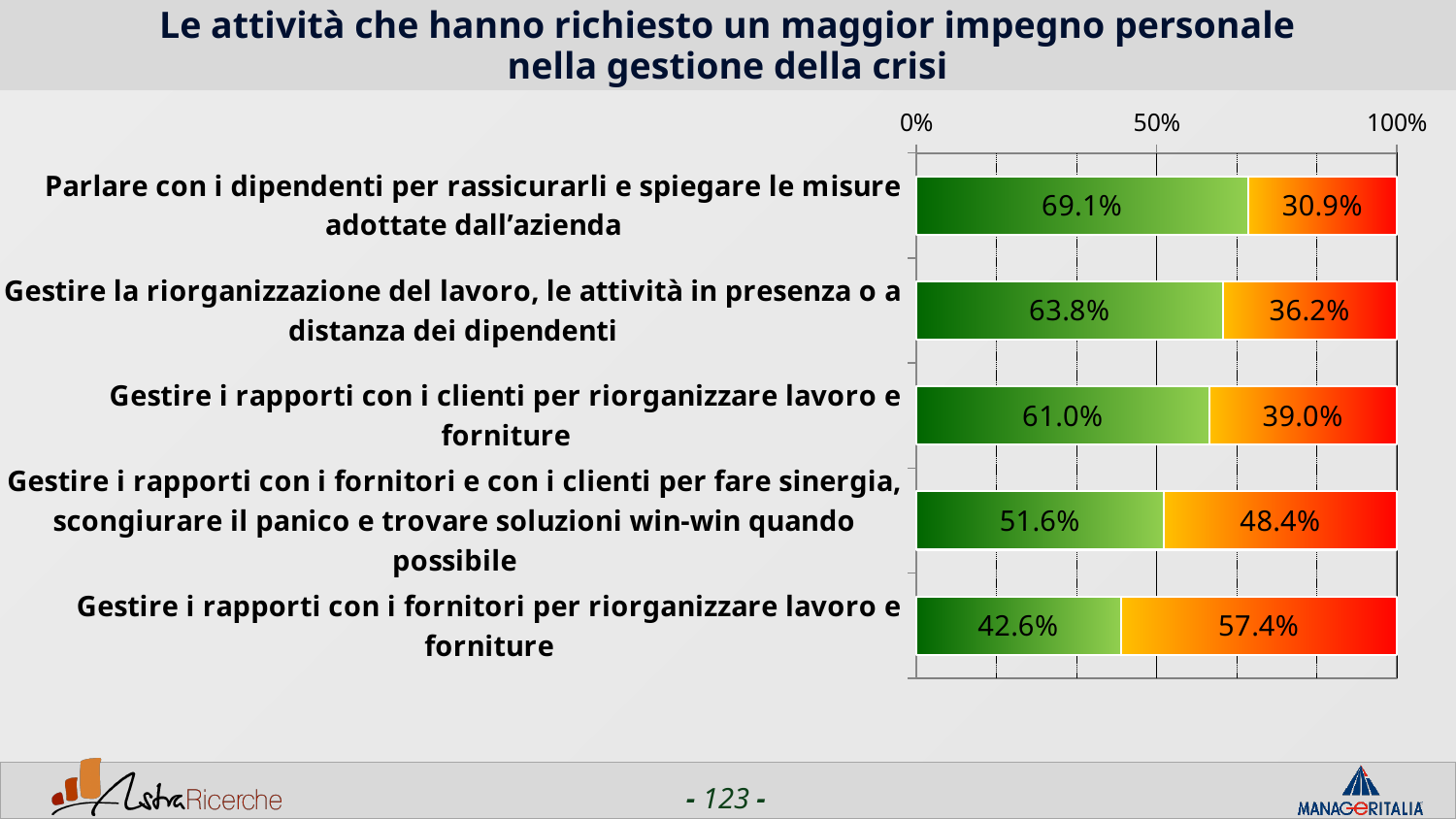
What is the green segment value for "Gestire i rapporti con i clienti per riorganizzare lavoro e forniture"? 61.0% What is the total of the stacked bar for "Gestire i rapporti con i clienti per riorganizzare lavoro e forniture"? 100% What is the orange segment value for "Gestire la riorganizzazione del lavoro, le attività in presenza o a distanza dei dipendenti"? 36.2% Which activity has the lowest green segment value? Gestire i rapporti con i fornitori per riorganizzare lavoro e forniture How many categories (activities) are plotted in the chart? 5 What kind of chart is shown on the slide? Stacked bar chart Which is larger: the green segment for "Gestire i rapporti con i fornitori e con i clienti per fare sinergia..." or its orange segment? The green segment (51.6%) Which activity has the highest green segment value? Parlare con i dipendenti per rassicurarli e spiegare le misure adottate dall'azienda What is the title of the chart on the slide? Le attività che hanno richiesto un maggior impegno personale nella gestione della crisi What is the orange segment value for "Gestire i rapporti con i fornitori per riorganizzare lavoro e forniture"? 57.4% What is the difference between the green segment values for "Parlare con i dipendenti..." (69.1%) and "Gestire i rapporti con i fornitori per riorganizzare lavoro e forniture" (42.6%)? 26.5% What is the green segment value for "Parlare con i dipendenti per rassicurarli e spiegare le misure adottate dall'azienda"? 69.1%